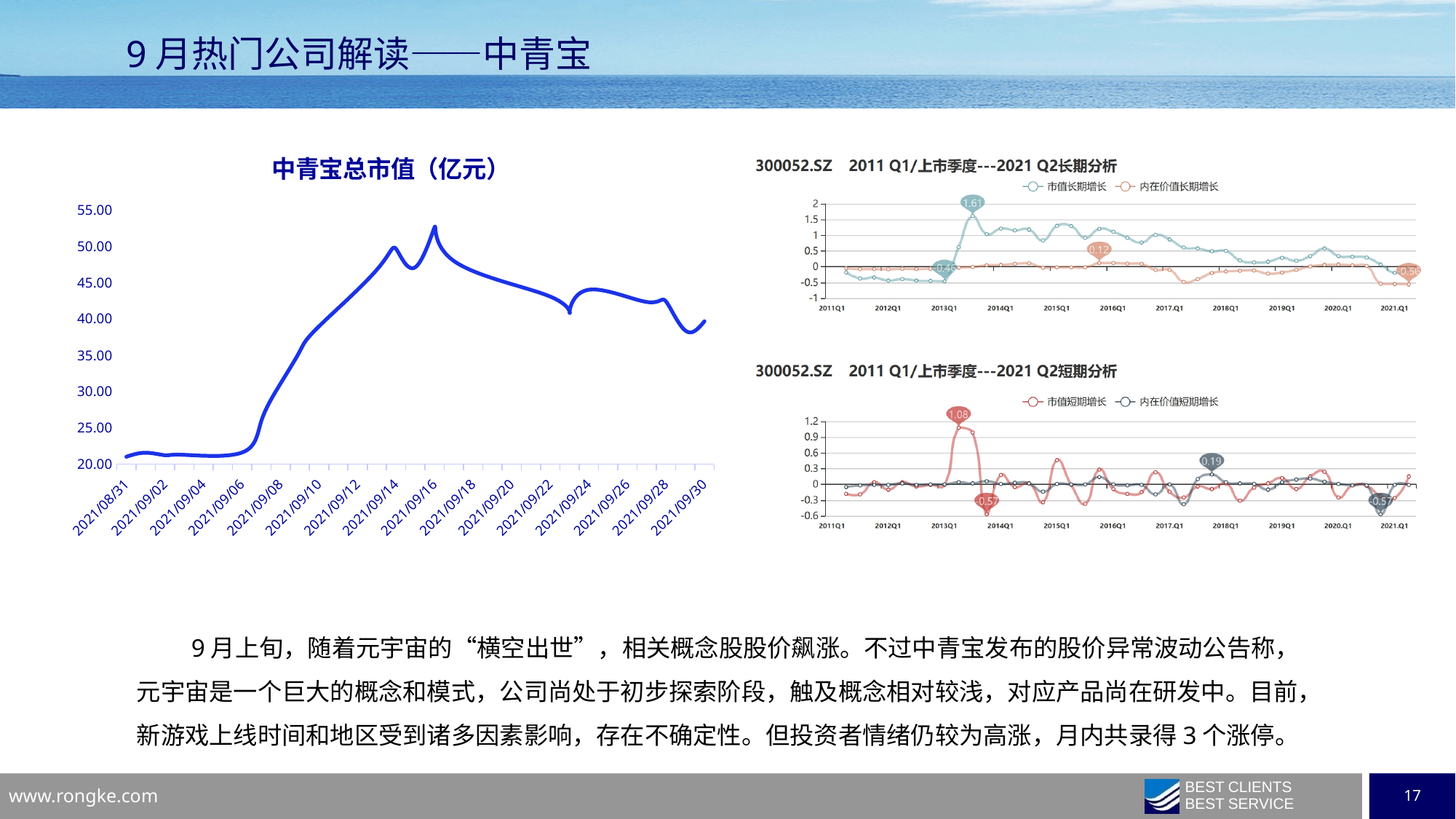
What kind of chart is the chart titled 中青宝总市值（亿元）? line chart In the chart titled 300052.SZ 2011 Q1/上市季度---2021 Q2短期分析, what are the two series listed in the legend? 市值短期增长 and 内在价值短期增长 In the chart titled 中青宝总市值（亿元）, do the values rise or fall from 2021/08/31 to 2021/09/16? rise In the chart titled 300052.SZ 2011 Q1/上市季度---2021 Q2短期分析, what is the labelled value of the 内在价值短期增长 series near 2018Q1? 0.19 In the chart titled 中青宝总市值（亿元）, is the value for 2021/08/31 greater or less than 25.00? less In the chart titled 300052.SZ 2011 Q1/上市季度---2021 Q2长期分析, how many series does the legend list? 2 In the chart titled 300052.SZ 2011 Q1/上市季度---2021 Q2长期分析, what is the highest labelled value of the 市值长期增长 series? 1.61 In the chart titled 中青宝总市值（亿元）, is the value for 2021/09/16 greater or less than 50.00? greater In the chart titled 300052.SZ 2011 Q1/上市季度---2021 Q2短期分析, what is the highest labelled value of the 市值短期增长 series? 1.08 In the chart titled 中青宝总市值（亿元）, is the value for 2021/09/30 greater or less than 45.00? less In the chart titled 中青宝总市值（亿元）, which date has the higher value, 2021/08/31 or 2021/09/16? 2021/09/16 In the chart titled 中青宝总市值（亿元）, what is the highest value shown on the vertical axis? 55.00